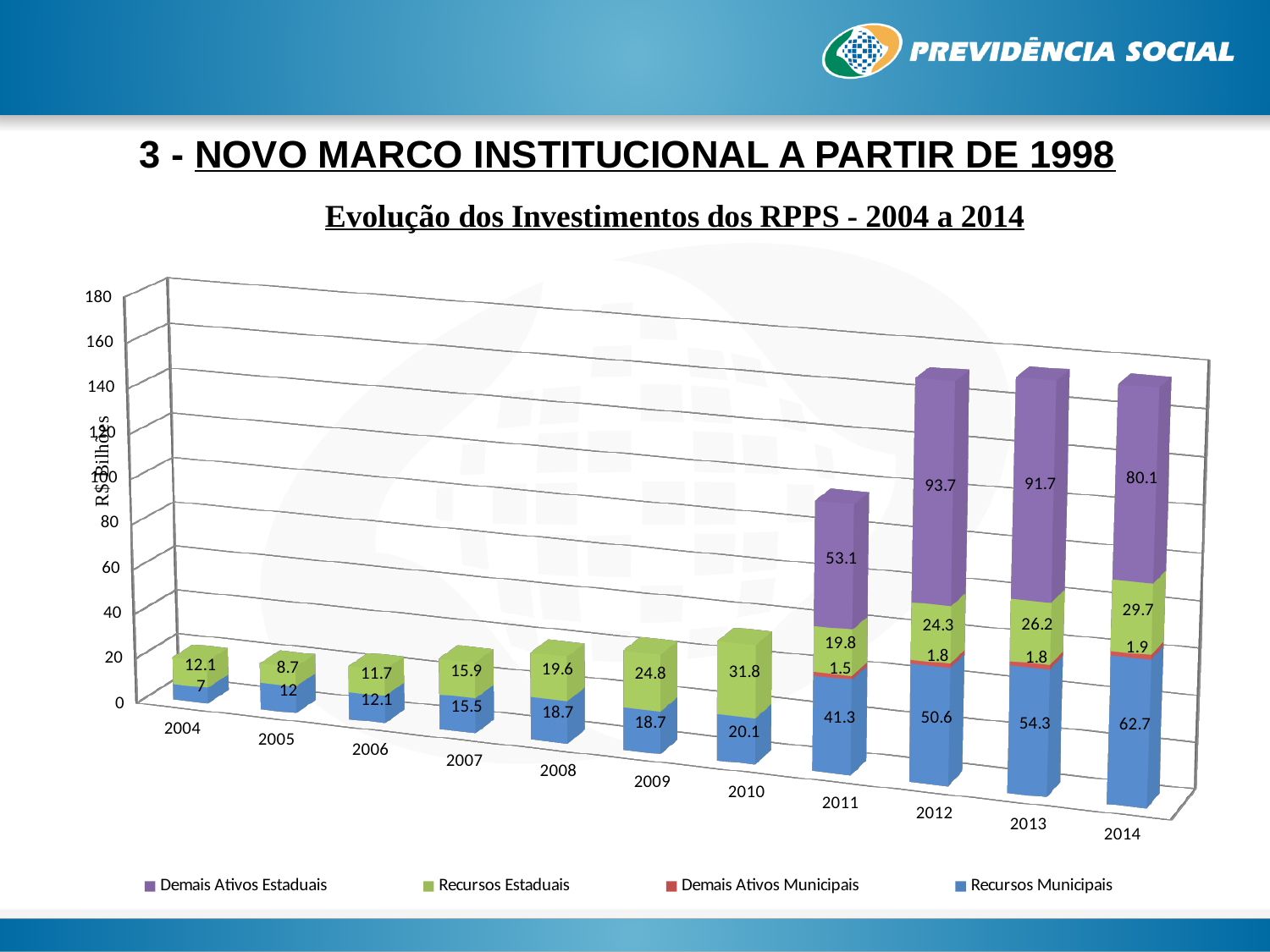
In which year is the Recursos Municipais value the lowest? 2004 What is the total of the stacked bar for 2004? 19.1 What is the value of Recursos Estaduais in 2010? 31.8 What is the value of Demais Ativos Estaduais in 2012? 93.7 Which year has the larger Recursos Estaduais value, 2004 or 2005? 2004 In which year is the Demais Ativos Estaduais value the highest? 2012 What kind of chart is shown on the slide? Stacked bar chart Does the Recursos Municipais value generally rise or fall from 2004 to 2014? Rise What is the difference between the Recursos Municipais values for 2014 and 2013? 8.4 What is the value of Recursos Municipais in 2014? 62.7 How many series does the legend list? 4 How many years are shown on the x axis? 11